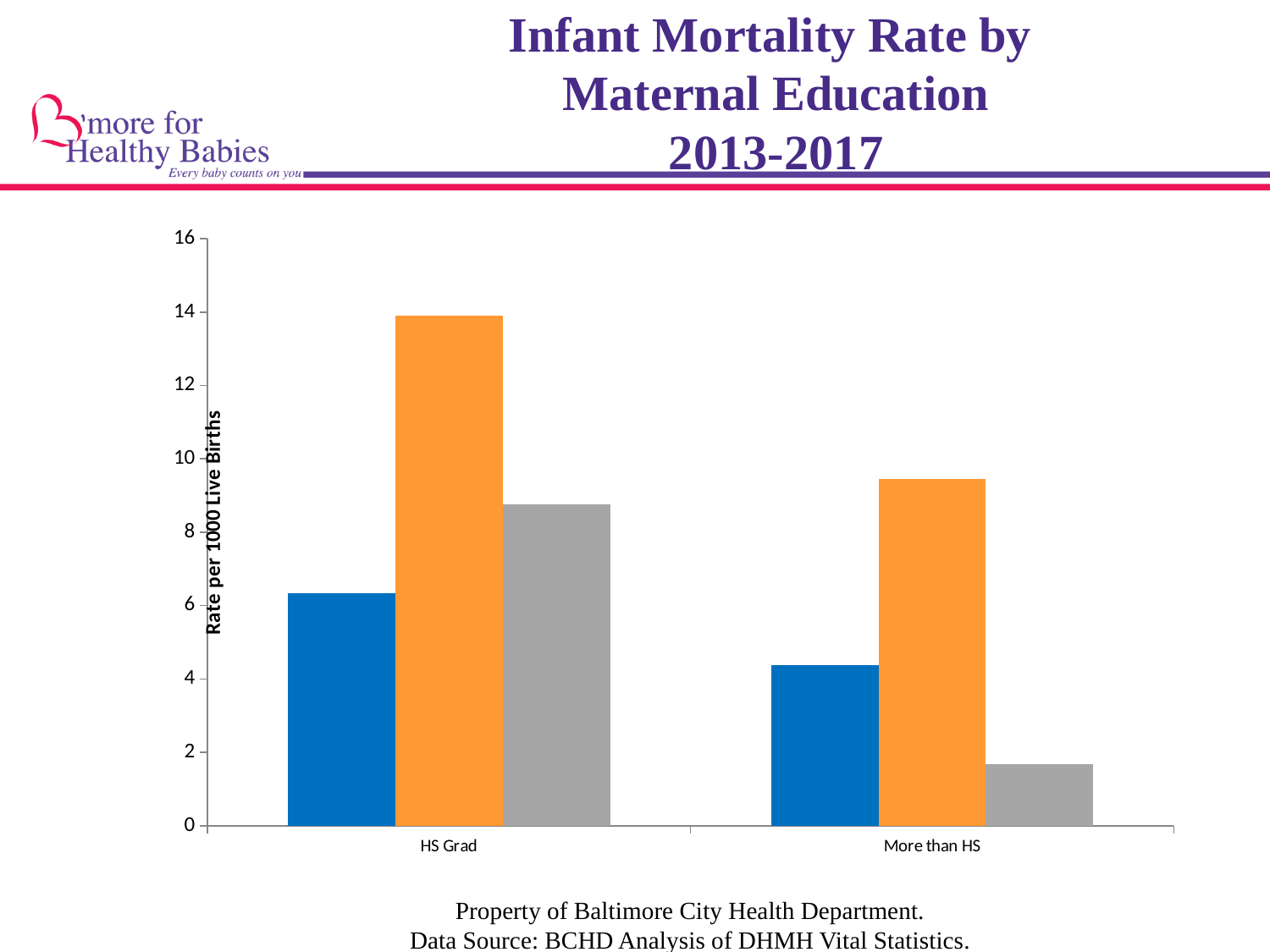
Is the value of the orange bar for HS Grad greater or less than 12? greater Which category has the taller orange bar, HS Grad or More than HS? HS Grad Which bar is the shortest in the whole chart? the gray bar for More than HS What is the label on the vertical axis of the chart? Rate per 1000 Live Births Is the value of the orange bar for More than HS greater or less than 8? greater Is the value of the gray bar for More than HS greater or less than 2? less Which bar is the tallest in the whole chart? the orange bar for HS Grad How many categories are shown on the x axis of the chart? 2 What are the two categories shown on the x axis? HS Grad and More than HS What kind of chart is shown on the slide? bar chart